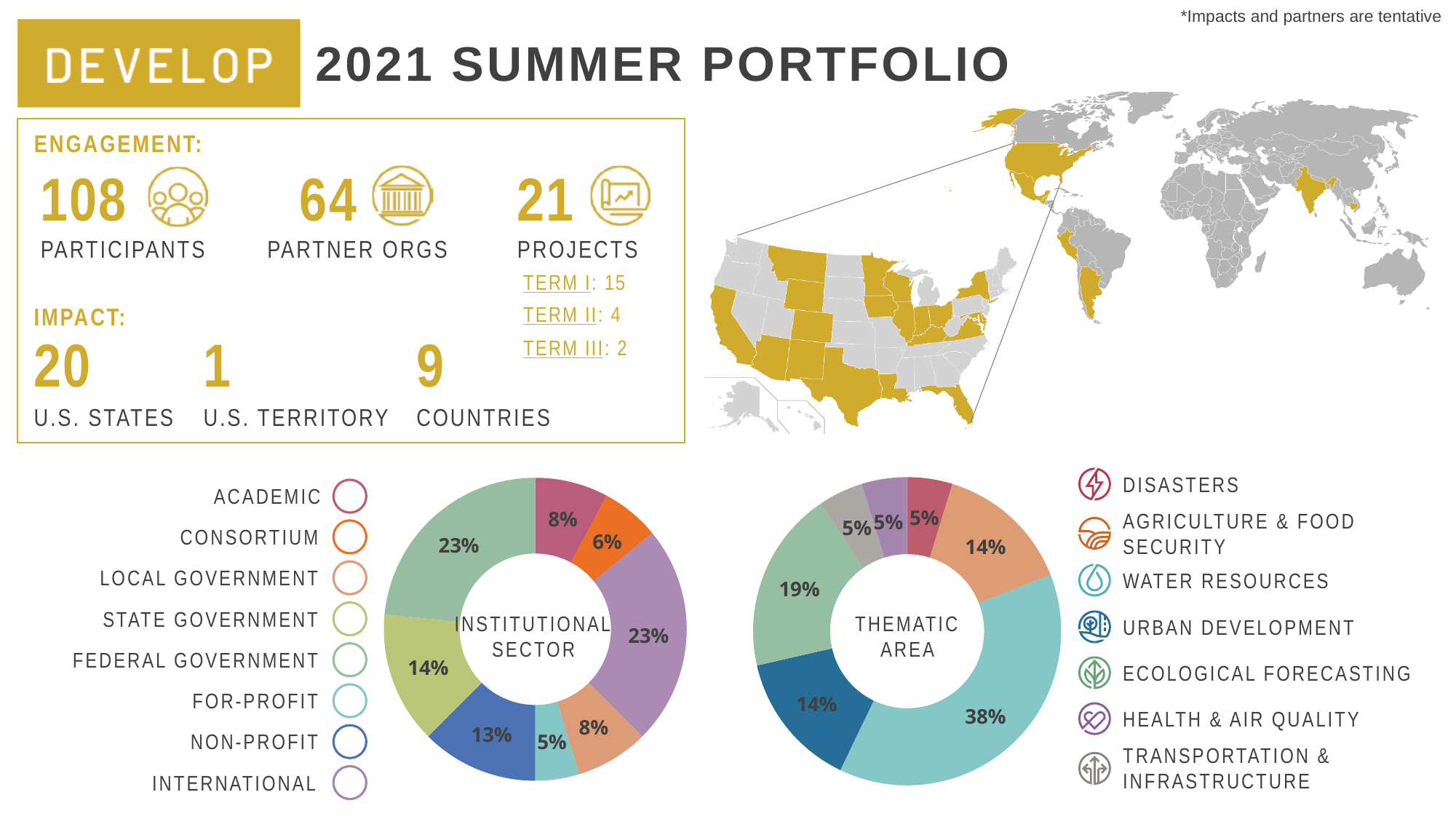
In the Thematic Area chart, which is larger: Agriculture & Food Security or Disasters? Agriculture & Food Security In the Institutional Sector chart, what share is Consortium? 6% In the Institutional Sector chart, which category has the smallest share? For-Profit In the Institutional Sector chart, how many categories does the legend list? 8 In the Institutional Sector chart, what share is Non-Profit? 13% In the Thematic Area chart, how many categories does the legend list? 7 In the Thematic Area chart, what share is Water Resources? 38% In the Institutional Sector chart, what share is Federal Government? 23% In the Thematic Area chart, what share is Ecological Forecasting? 19% In the Thematic Area chart, which category has the largest share? Water Resources What kind of chart is the Thematic Area chart? Pie (donut) chart In the Institutional Sector chart, what is the difference between the State Government share and the For-Profit share? 9%